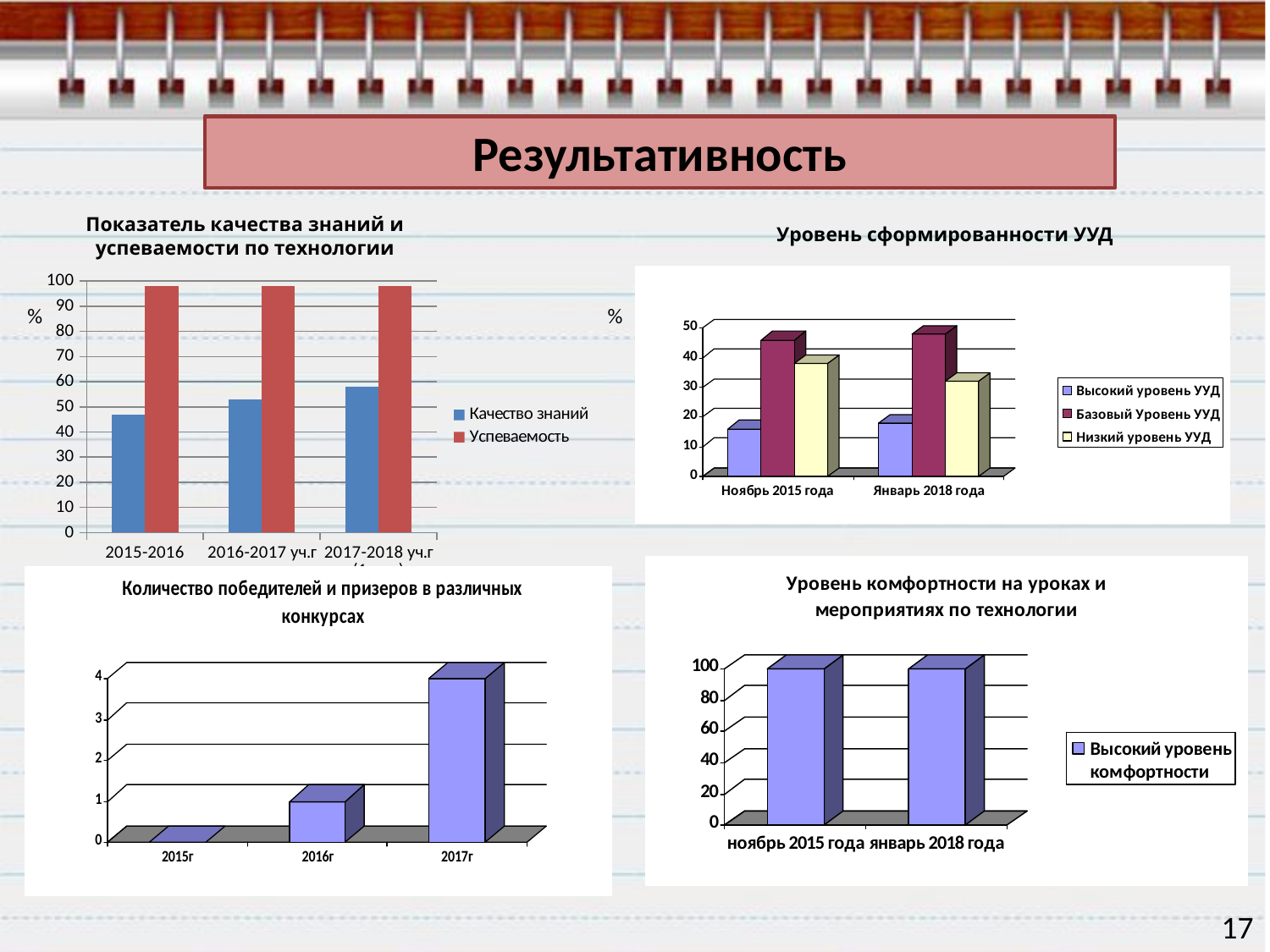
In the chart titled "Показатель качества знаний и успеваемости по технологии", is the value of Качество знаний for 2015-2016 greater or less than 50? less In the chart titled "Количество победителей и призеров в различных конкурсах", what is the difference between the values for 2017г and 2016г? 3 In the chart titled "Количество победителей и призеров в различных конкурсах", how many categories are shown on the x axis? 3 In the chart titled "Показатель качества знаний и успеваемости по технологии", how many series does the legend list? 2 In the chart titled "Уровень сформированности УУД", is the value of Высокий уровень УУД for Ноябрь 2015 года greater or less than 20? less In the chart titled "Уровень сформированности УУД", how many series does the legend list? 3 In the chart titled "Уровень комфортности на уроках и мероприятиях по технологии", is the value for ноябрь 2015 года greater or less than 80? greater In the chart titled "Уровень сформированности УУД", which series has the highest value for Ноябрь 2015 года? Базовый Уровень УУД In the chart titled "Показатель качества знаний и успеваемости по технологии", which is larger for 2017-2018 уч.г: Качество знаний or Успеваемость? Успеваемость In the chart titled "Показатель качества знаний и успеваемости по технологии", what kind of chart is shown? bar chart In the chart titled "Количество победителей и призеров в различных конкурсах", what is the value for 2017г? 4 In the chart titled "Показатель качества знаний и успеваемости по технологии", does Качество знаний rise or fall from 2015-2016 to 2017-2018 уч.г? rises